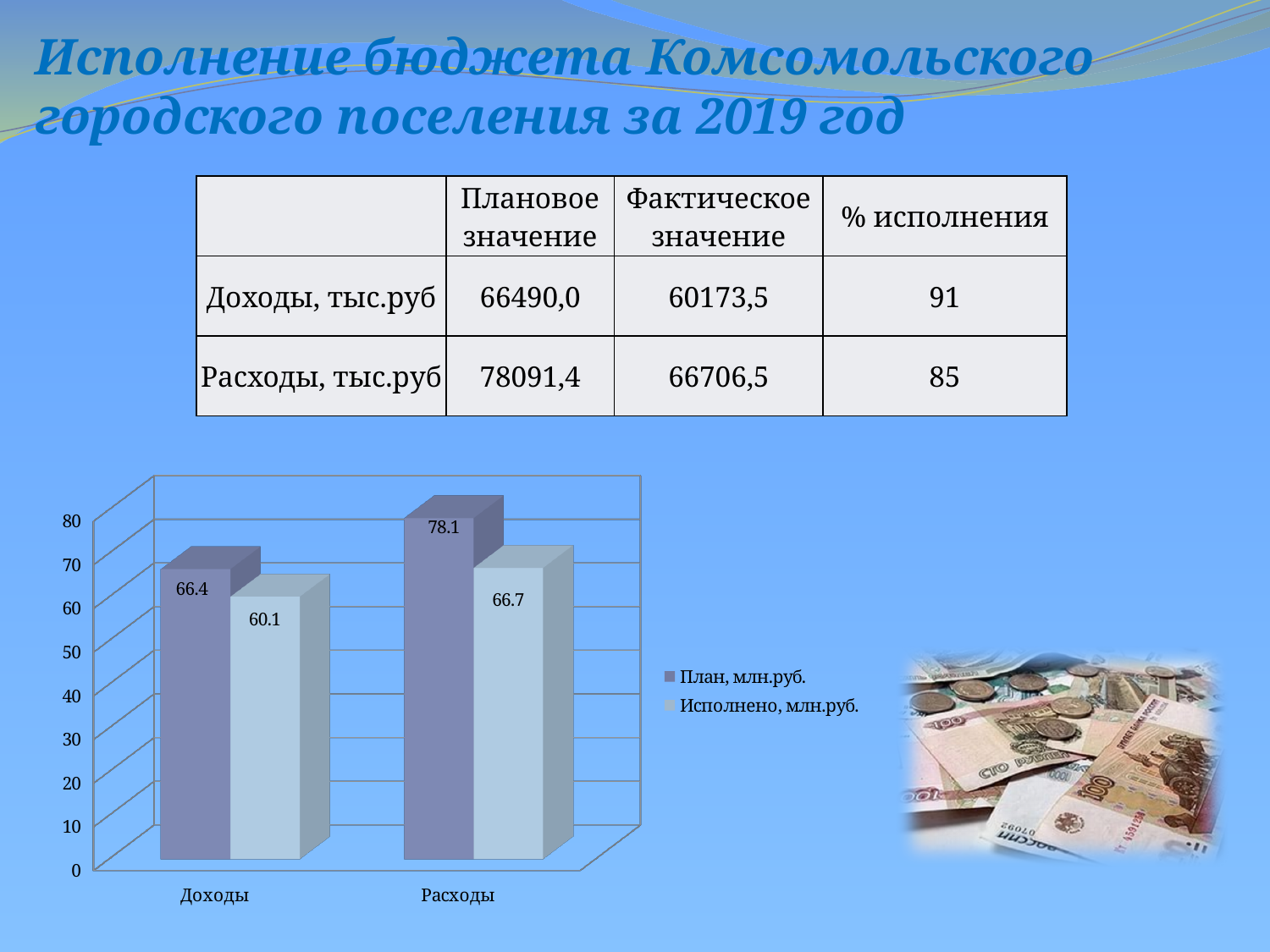
Which category has the highest План, млн.руб. value? Расходы What is the value of Исполнено, млн.руб. for Доходы? 60.1 What is the value of План, млн.руб. for Расходы? 78.1 What kind of chart is shown on the slide? Bar chart What is the difference between План, млн.руб. and Исполнено, млн.руб. for Расходы? 11.4 How many series does the chart legend list? 2 Which category has the lowest Исполнено, млн.руб. value? Доходы What is the value of План, млн.руб. for Доходы? 66.4 How many categories are shown on the x axis of the chart? 2 What is the value of Исполнено, млн.руб. for Расходы? 66.7 Which is larger: Исполнено, млн.руб. for Расходы or План, млн.руб. for Доходы? Исполнено, млн.руб. for Расходы What is the difference between План, млн.руб. and Исполнено, млн.руб. for Доходы? 6.3